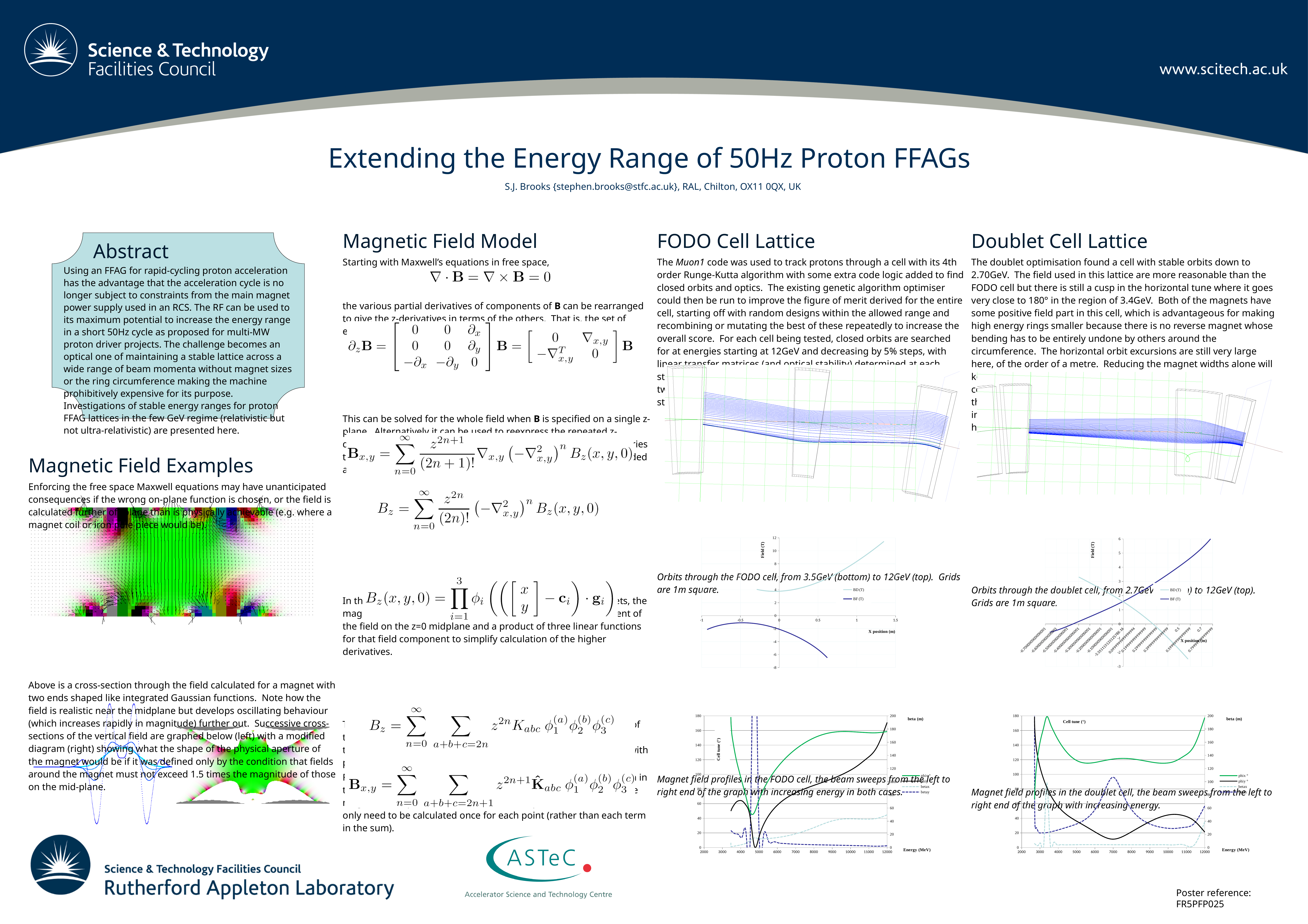
In the doublet cell tune chart, is the phix value at 7000 MeV greater or less than 100? greater In the doublet cell tune chart, is the phiy value at 7000 MeV greater or less than 60? less In the FODO cell tune chart (Cell tune vs Energy (MeV)), how many series does the legend list? 4 In the FODO cell tune chart, what is the x-axis label? Energy (MeV) In the FODO cell magnet field profile chart (Field (T) vs X position (m)), what kind of chart is it? line chart In the FODO cell magnet field profile chart, is the BF (T) value at X position 0.5 greater or less than -2? less In the FODO cell magnet field profile chart, how many series does the legend list? 2 In the FODO cell magnet field profile chart, what are the two legend entries? BD (T) and BF (T) In the doublet cell magnet field profile chart, how many series does the legend list? 2